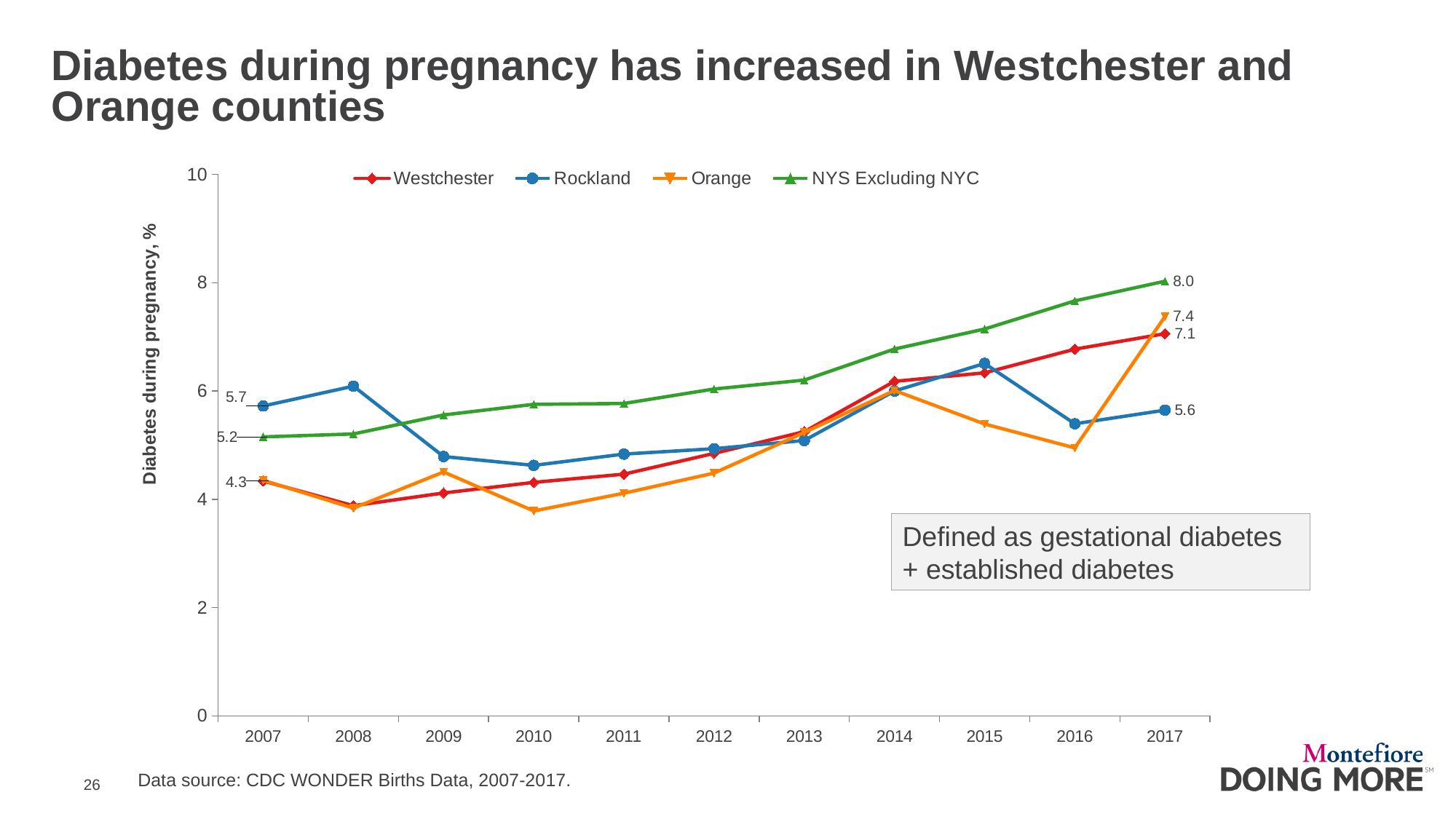
What is the value for Orange in 2017? 7.4 Which series has the lowest value in 2017? Rockland By how much did the value for NYS Excluding NYC increase from 2007 to 2017? 2.8 Is the value for Orange in 2010 greater or less than 4? less How many series does the legend list? 4 What is the value for Westchester in 2017? 7.1 How many years are shown on the x axis? 11 What kind of chart is shown on the slide? Line chart What is the value for Rockland in 2017? 5.6 What is the value for NYS Excluding NYC in 2017? 8.0 Which series has the highest value in 2017? NYS Excluding NYC What is the value for Rockland in 2007? 5.7